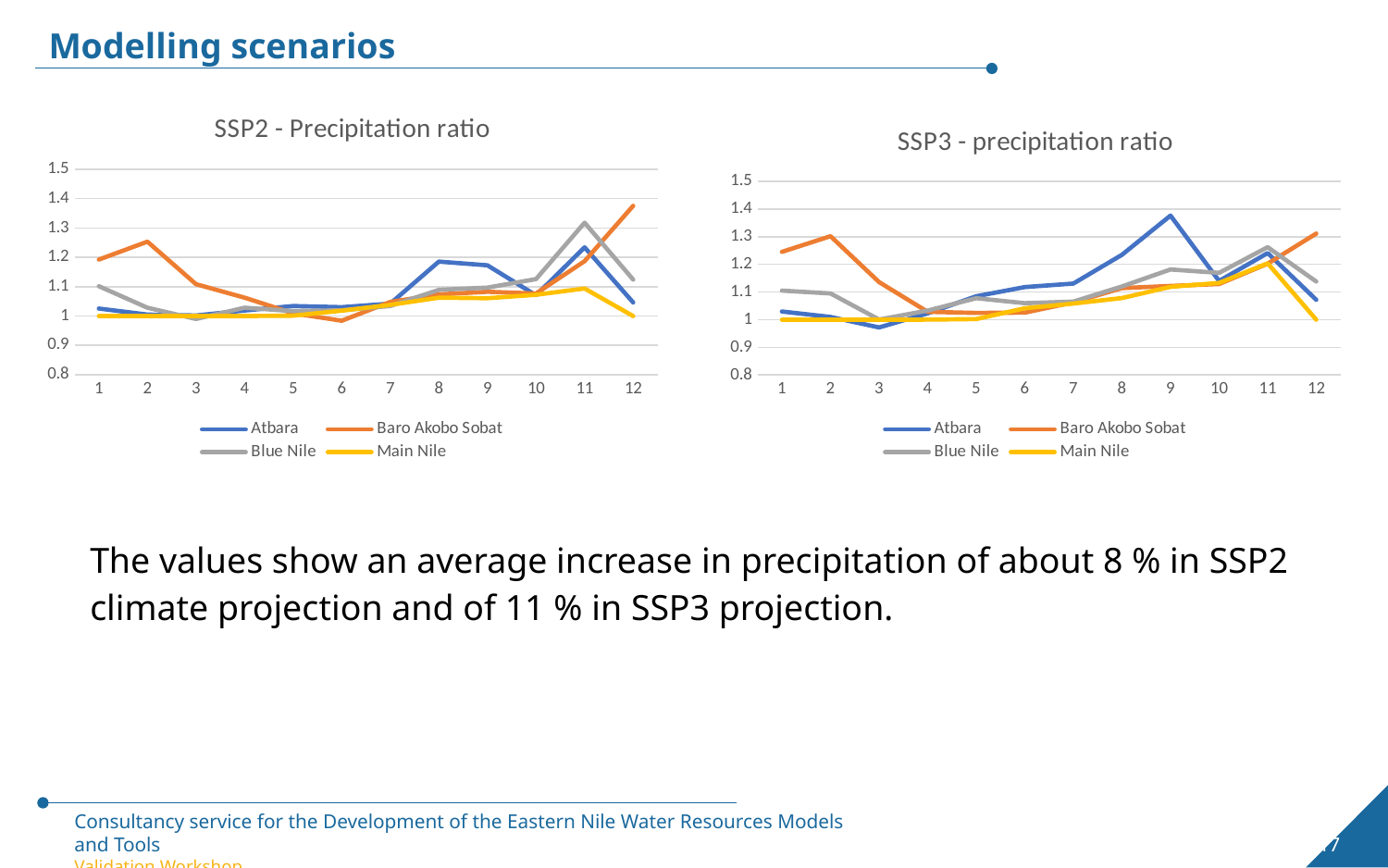
In the SSP2 - Precipitation ratio chart, which series has the lowest value at 12? Main Nile In the SSP2 - Precipitation ratio chart, which series has the highest value at 12? Baro Akobo Sobat In the SSP3 - precipitation ratio chart, is the value for Atbara at 3 greater or less than 1? less How many series does the legend of the SSP3 - precipitation ratio chart list? 4 In the SSP2 - Precipitation ratio chart, is the value for Baro Akobo Sobat at 12 greater or less than 1.3? greater What kind of chart is the SSP2 - Precipitation ratio chart? line chart In the SSP3 - precipitation ratio chart, does the Main Nile series generally rise or fall from 1 to 11? rise How many points along the x axis does each series in the SSP2 - Precipitation ratio chart have? 12 In the SSP2 - Precipitation ratio chart, is the value for Main Nile at 12 greater or less than 1.1? less In the SSP3 - precipitation ratio chart, at 9, which is larger: Atbara or Main Nile? Atbara In the SSP3 - precipitation ratio chart, which series has the highest value at 9? Atbara